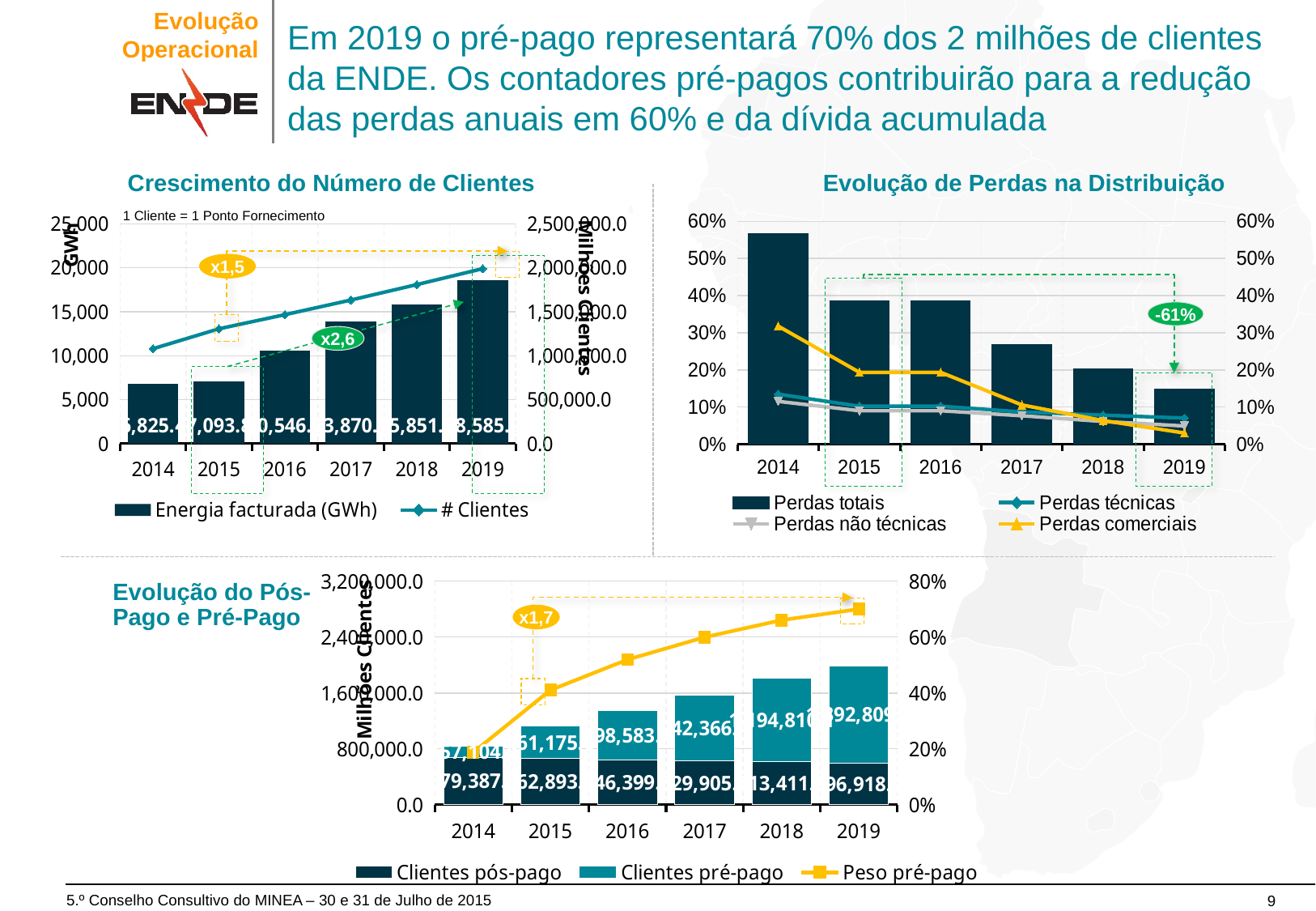
In the "Crescimento do Número de Clientes" chart, which year has the highest Energia facturada (GWh)? 2019 In the "Evolução do Pós-Pago e Pré-Pago" chart, how many series does the legend list? 3 In the "Evolução de Perdas na Distribuição" chart, how many series does the legend list? 4 In the "Crescimento do Número de Clientes" chart, how many series does the legend list? 2 In the "Crescimento do Número de Clientes" chart, is the Energia facturada (GWh) for 2014 greater or less than 10,000? less In the "Evolução de Perdas na Distribuição" chart, which year has the highest Perdas totais? 2014 In the "Crescimento do Número de Clientes" chart, how many years are shown on the x axis? 6 What type of chart is "Crescimento do Número de Clientes"? Combined bar and line chart In the "Evolução de Perdas na Distribuição" chart, is the Perdas totais value for 2014 greater or less than 50%? greater In the "Evolução de Perdas na Distribuição" chart, do the Perdas totais bars rise or fall from 2014 to 2019? fall In the "Evolução do Pós-Pago e Pré-Pago" chart, is the Peso pré-pago value for 2019 greater or less than 60%? greater In the "Crescimento do Número de Clientes" chart, does the # Clientes line rise or fall from 2014 to 2019? rises